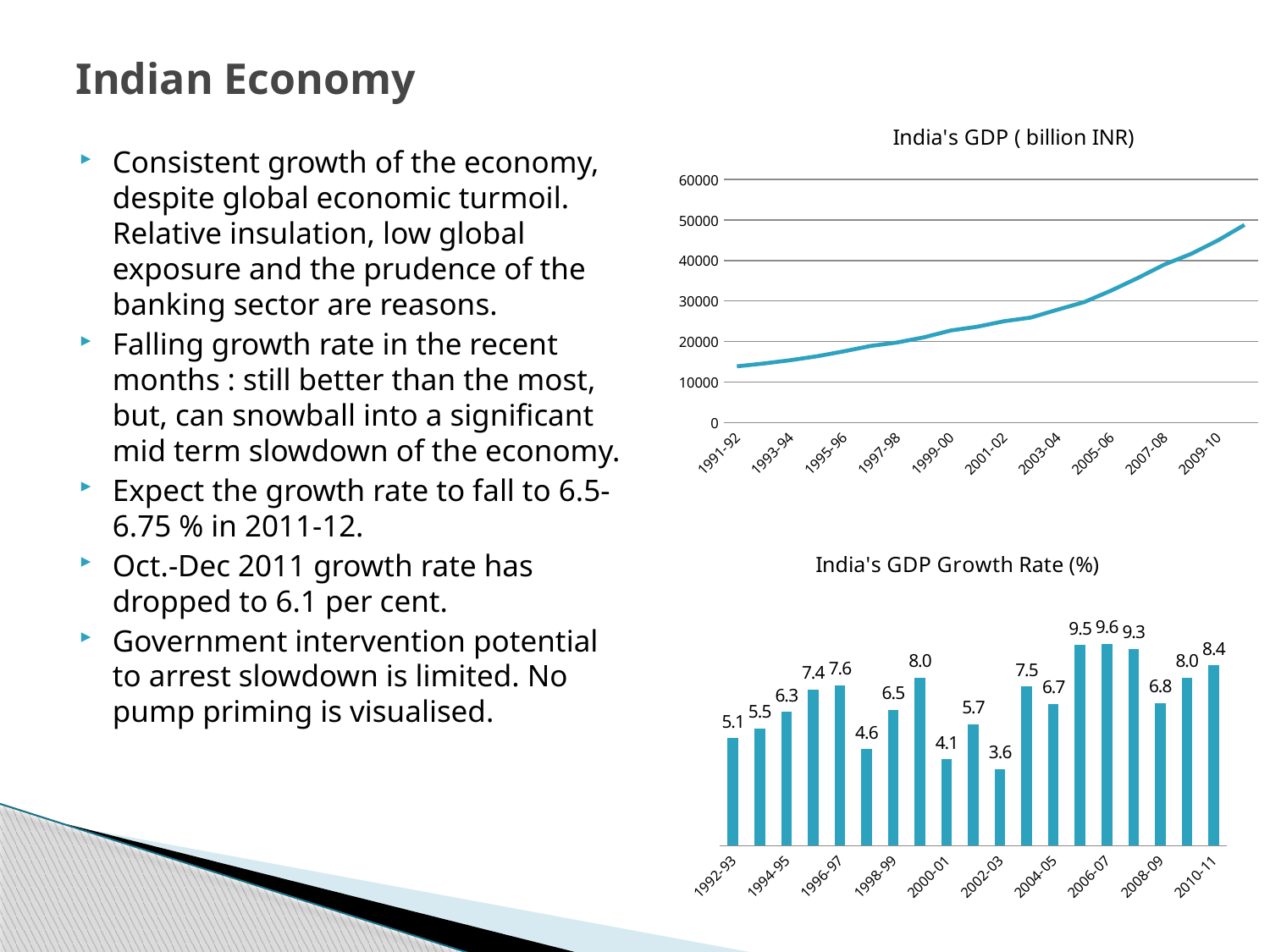
In the chart titled "India's GDP Growth Rate (%)", how many bars are plotted? 19 In the chart titled "India's GDP ( billion INR)", do the values rise or fall from 1991-92 to 2009-10? Rise In the chart titled "India's GDP Growth Rate (%)", which is larger, the value for 1996-97 or the value for 2000-01? 1996-97 In the chart titled "India's GDP Growth Rate (%)", which year has the lowest growth rate? 2002-03 In the chart titled "India's GDP Growth Rate (%)", what is the value for 2002-03? 3.6 What kind of chart is the one titled "India's GDP ( billion INR)"? Line chart In the chart titled "India's GDP Growth Rate (%)", which year has the highest growth rate? 2006-07 In the chart titled "India's GDP ( billion INR)", is the value for 2009-10 greater or less than 40000? greater In the chart titled "India's GDP Growth Rate (%)", what is the value for 1992-93? 5.1 In the chart titled "India's GDP Growth Rate (%)", what is the difference between the values for 2010-11 and 2008-09? 1.6 What kind of chart is the one titled "India's GDP Growth Rate (%)"? Bar chart In the chart titled "India's GDP Growth Rate (%)", what is the value for 2006-07? 9.6